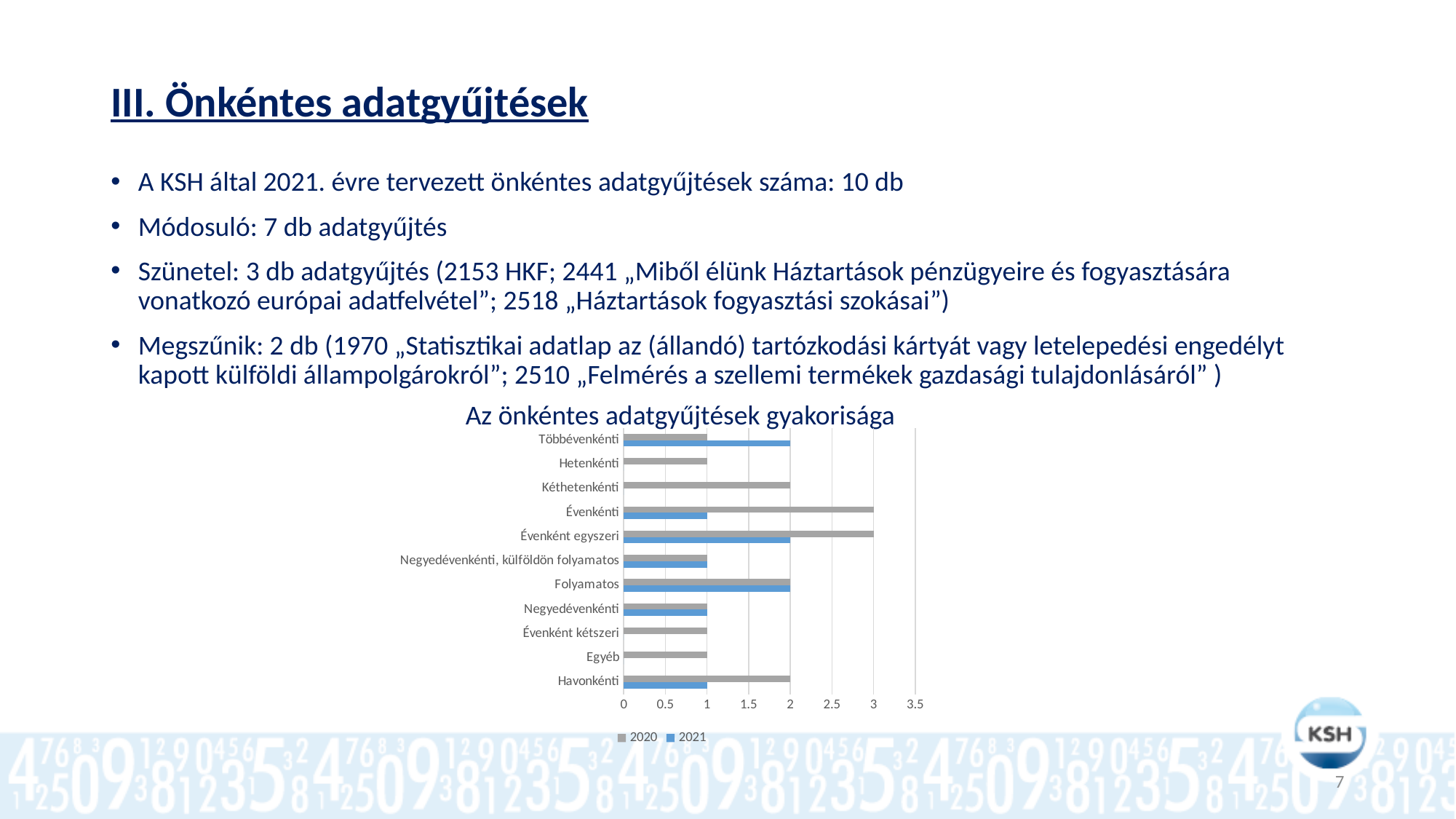
What is the title of the chart on the slide? Az önkéntes adatgyűjtések gyakorisága For Évenkénti, which series has the larger value, 2020 or 2021? 2020 What kind of chart is shown on the slide? bar chart What is the 2021 value for Évenkénti? 1 How many categories are shown on the chart's vertical axis? 11 What is the 2020 value for Kéthetenkénti? 2 How many series does the chart's legend list? 2 What is the difference between the 2020 and 2021 values for Évenkénti? 2 What is the 2020 value for Havonkénti? 2 What is the 2020 value for Évenkénti? 3 Which series is shown in blue in the chart? 2021 What is the 2021 value for Többévenkénti? 2